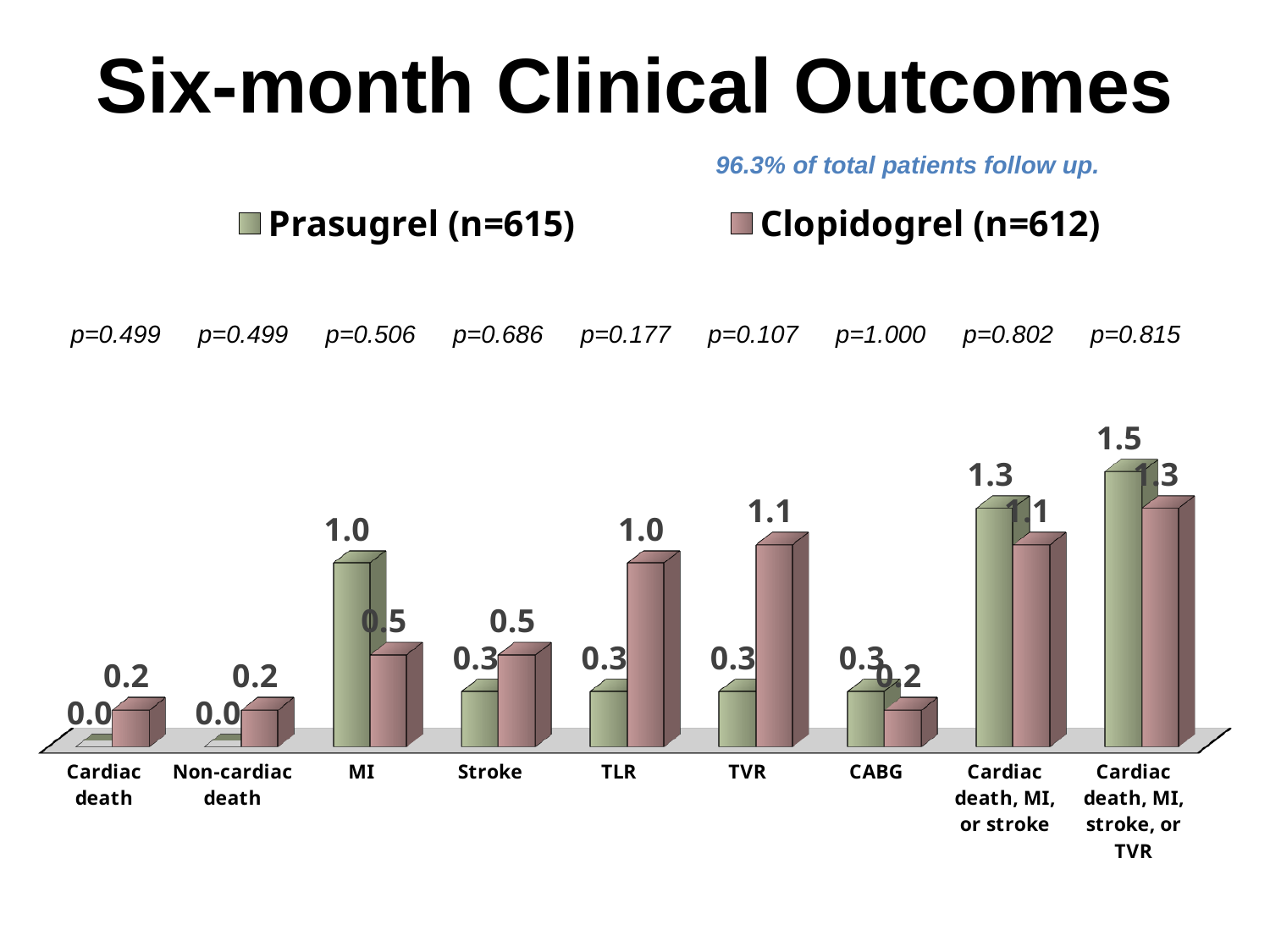
What is the Clopidogrel (n=612) value for TVR? 1.1 Which category has the highest Prasugrel (n=615) value? Cardiac death, MI, stroke, or TVR What is the Prasugrel (n=615) value for Cardiac death, MI, stroke, or TVR? 1.5 What kind of chart is shown on the slide? Bar chart What is the Prasugrel (n=615) value for MI? 1.0 What is the Clopidogrel (n=612) value for Cardiac death? 0.2 How many categories are shown on the x axis? 9 How many series does the legend list? 2 For MI, which series has the larger value, Prasugrel (n=615) or Clopidogrel (n=612)? Prasugrel (n=615) What is the difference between the Clopidogrel (n=612) and Prasugrel (n=615) values for TLR? 0.7 Which category has the highest Clopidogrel (n=612) value? Cardiac death, MI, stroke, or TVR For Stroke, which series has the larger value, Prasugrel (n=615) or Clopidogrel (n=612)? Clopidogrel (n=612)